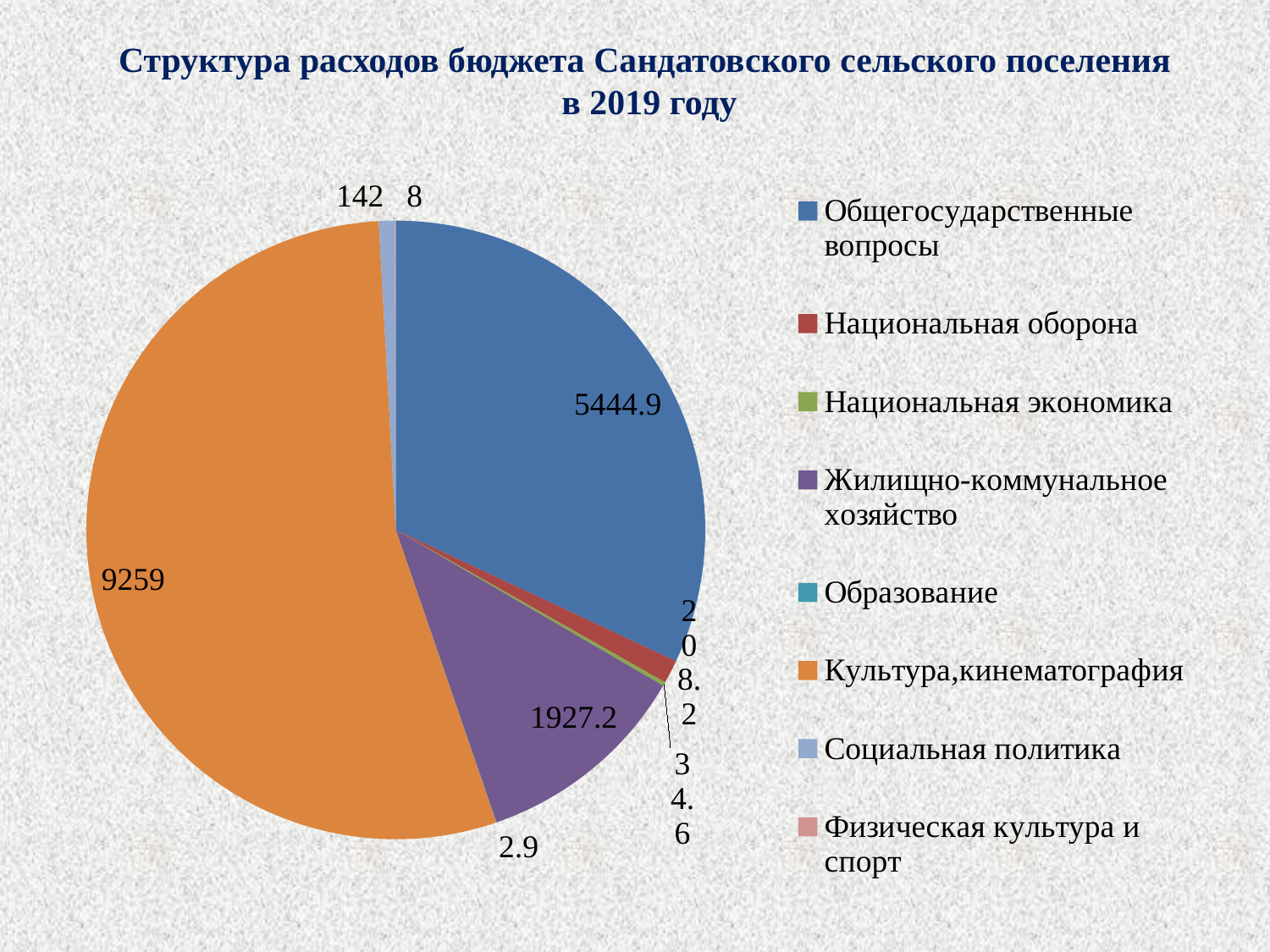
What is the value for Физическая культура и спорт? 8 What is the value for Социальная политика? 142 What is the difference between the values for Культура,кинематография and Общегосударственные вопросы? 3814.1 Which category has the largest slice of the pie? Культура,кинематография What is the value for Общегосударственные вопросы? 5444.9 What is the value for Жилищно-коммунальное хозяйство? 1927.2 What kind of chart is shown on the slide? pie chart What is the difference between the values for Социальная политика and Физическая культура и спорт? 134 What is the value for Культура,кинематография? 9259 Which category has the smallest value? Образование Which is larger: Общегосударственные вопросы or Жилищно-коммунальное хозяйство? Общегосударственные вопросы How many categories does the legend list? 8